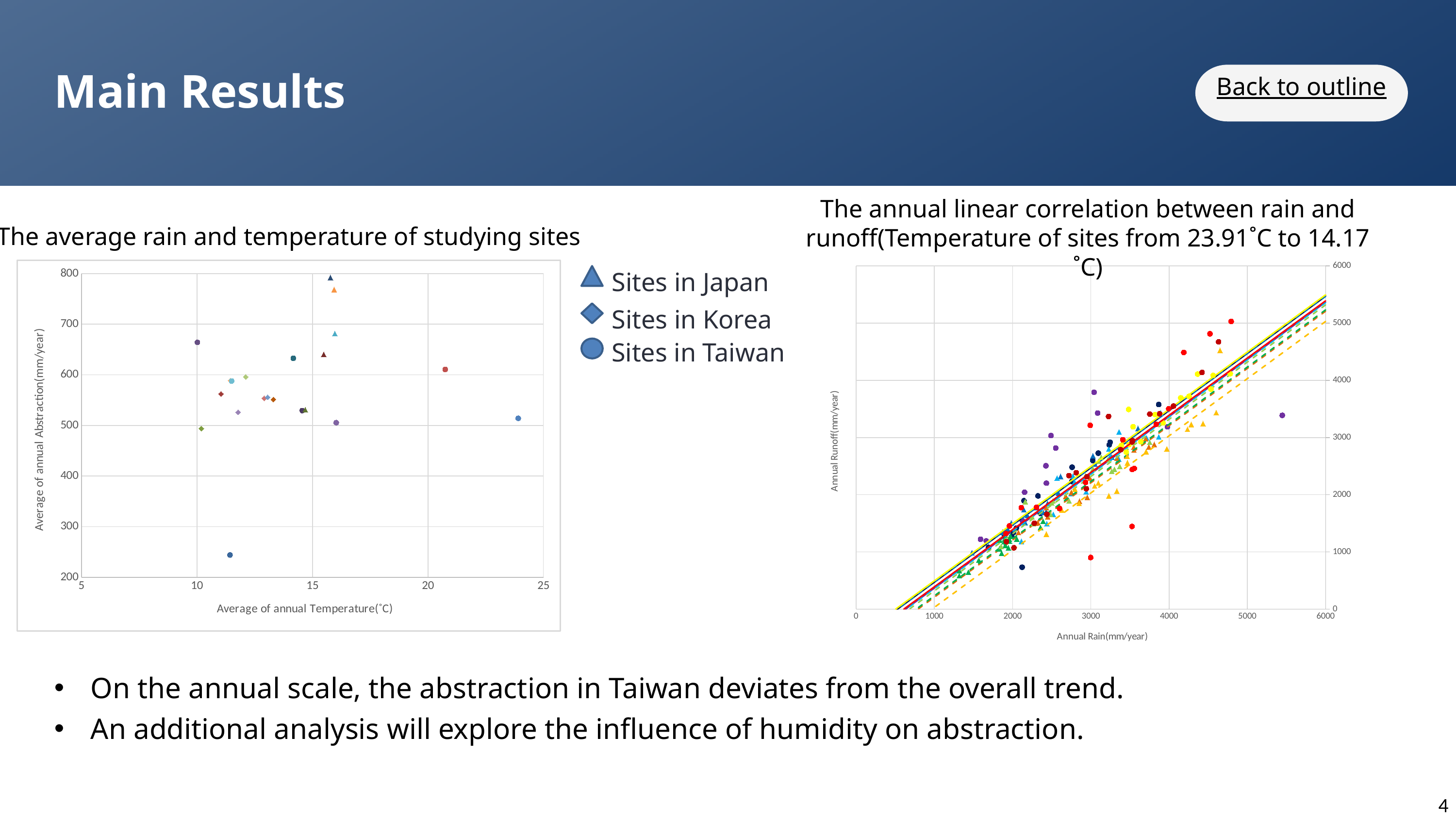
In the left chart, is the abstraction value for the site with the highest average temperature (near 24°C) greater or less than 400? greater What kind of chart is the left chart, 'The average rain and temperature of studying sites'? scatter chart In the left chart, is the highest plotted abstraction value greater or less than 700? greater What kind of chart is the right chart showing the annual linear correlation between rain and runoff? scatter chart In the right chart, what is the maximum value shown on the Annual Rain x axis? 6000 In the left chart, is the lowest plotted abstraction value greater or less than 300? less In the left chart, which marker shape represents Sites in Japan? triangle In the left chart, what is the title of the x axis? Average of annual Temperature(°C) In the right chart, do the annual runoff values generally rise or fall as annual rain increases? rise In the left chart, how many series does the legend list? 3